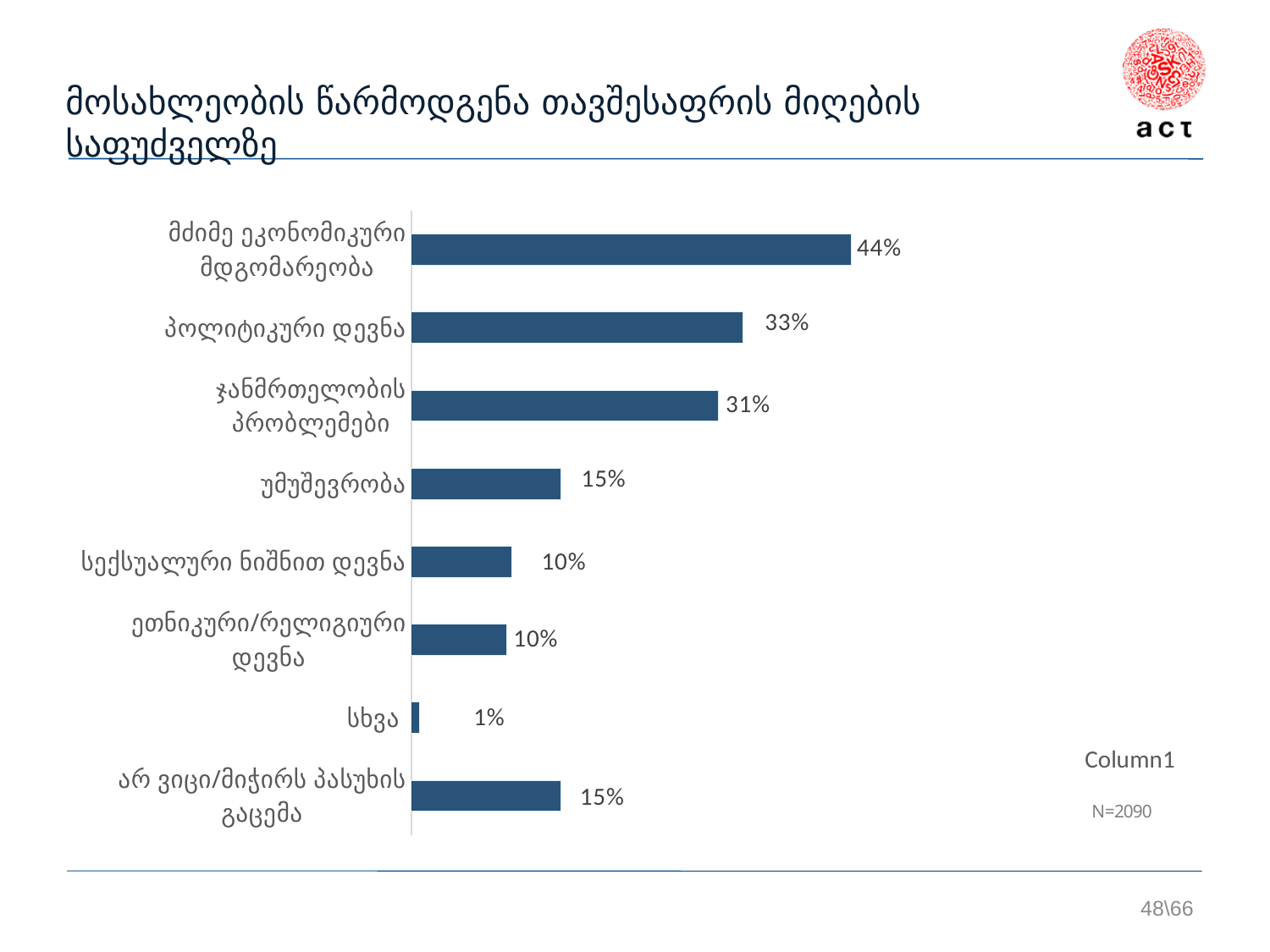
What kind of chart is shown on the slide? Bar chart What is the value for მძიმე ეკონომიკური მდგომარეობა? 44% Which category has the lowest value? სხვა What is the value for პოლიტიკური დევნა? 33% Which category has the highest value? მძიმე ეკონომიკური მდგომარეობა What is the value for სხვა? 1% What is the difference between the values for მძიმე ეკონომიკური მდგომარეობა and პოლიტიკური დევნა? 11% What is the value for ჯანმრთელობის პრობლემები? 31% Which is larger, the value for უმუშევრობა or the value for სექსუალური ნიშნით დევნა? უმუშევრობა What legend entry is shown on the chart? Column1 How many categories are shown in the chart? 8 What sample size (N) is shown on the slide? N=2090